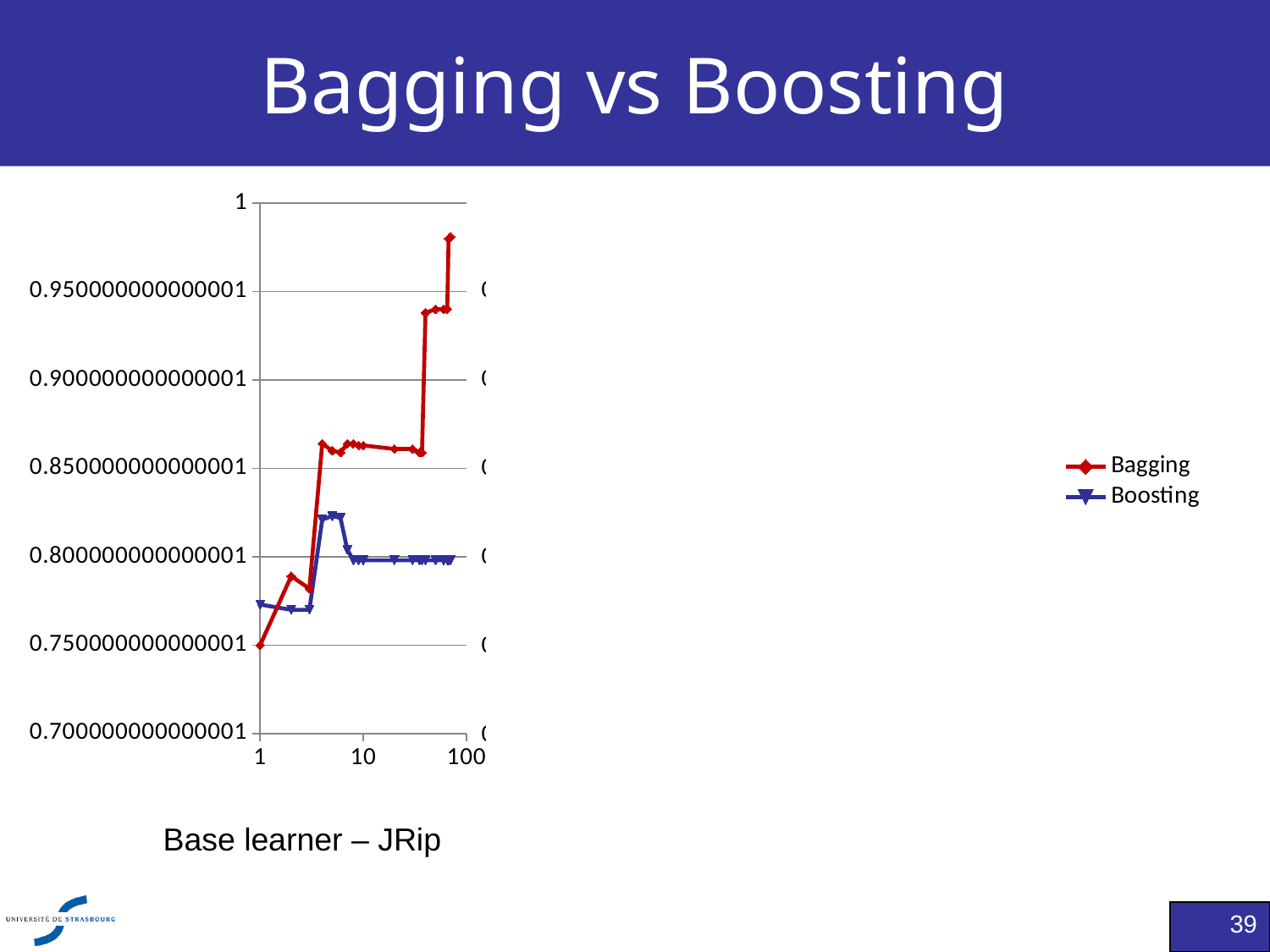
Is the value of Bagging at x = 10 greater or less than 0.85? greater What kind of chart is shown on the slide? line chart Does the Bagging line overall rise or fall as x increases from 1 to 100? rise How many labelled tick marks are on the x axis? 3 At x = 1, which series has the larger value, Bagging or Boosting? Boosting What colour is the Bagging line? red Which two series are listed in the legend? Bagging and Boosting How many series does the legend list? 2 Which series reaches the highest value on the chart? Bagging